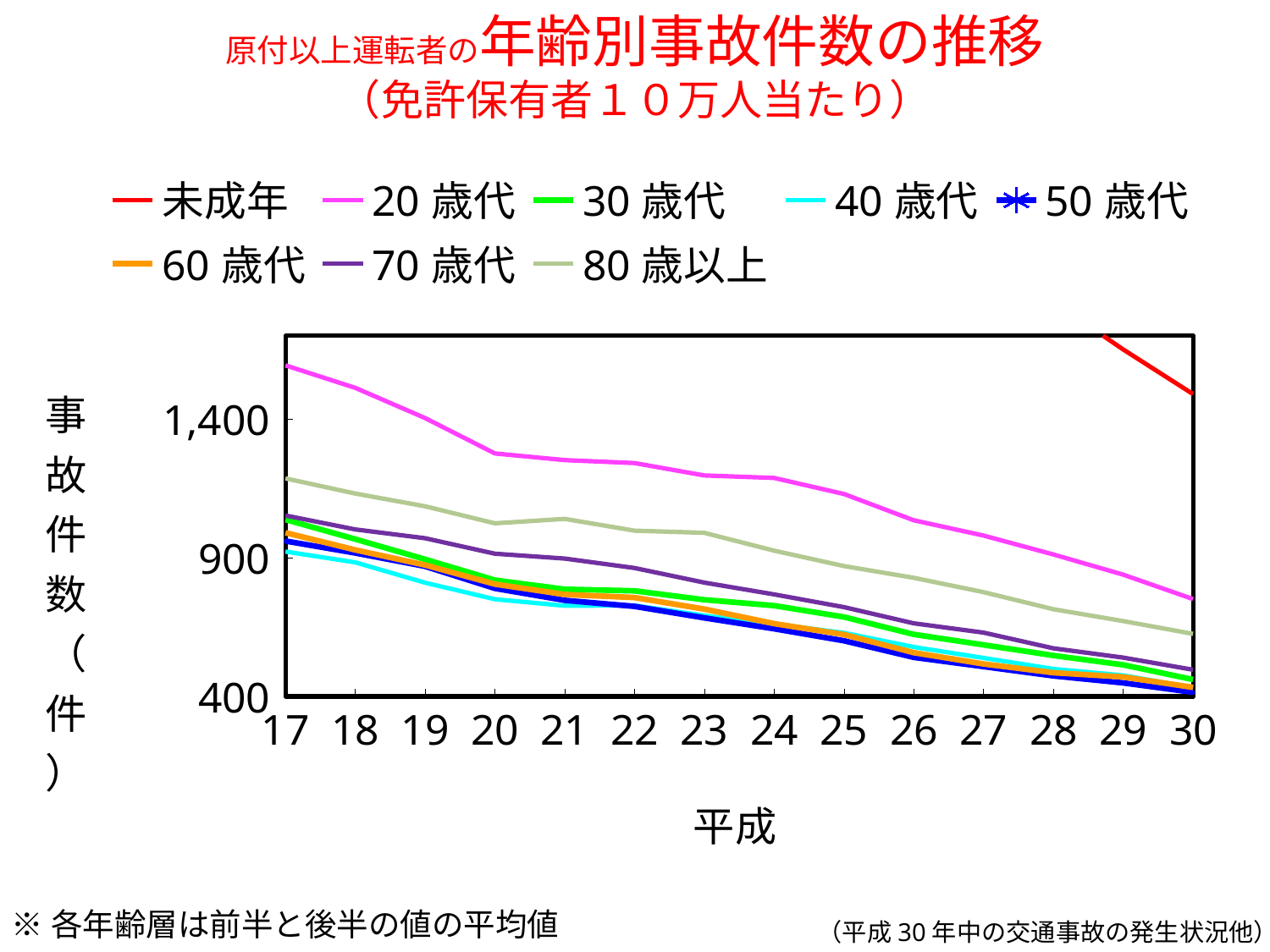
What is the label of the x axis? 平成 At 平成17, which is larger: 20歳代 or 80歳以上? 20歳代 Is the value for 20歳代 at 平成17 greater or less than 1,400? greater How many series does the legend list? 8 At 平成30, which is larger: 80歳以上 or 30歳代? 80歳以上 Which series has the highest value at 平成30? 未成年 Is the value for 70歳代 at 平成17 greater or less than 900? greater What kind of chart is shown on the slide? line chart Is the value for 20歳代 at 平成30 greater or less than 900? less Does the 20歳代 line rise or fall from 平成17 to 平成30? fall How many years are plotted along the x axis? 14